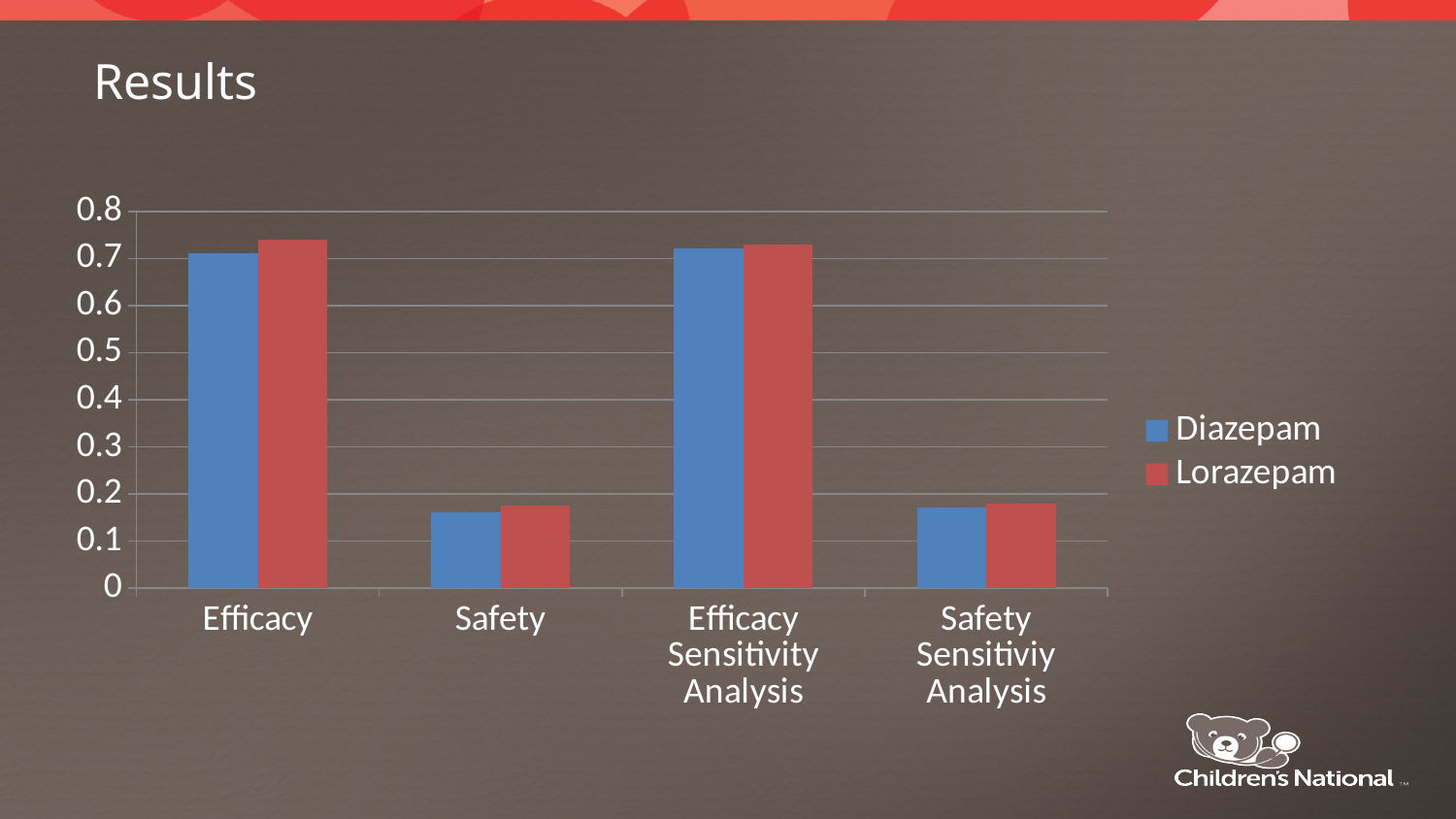
What is the title of the slide containing the chart? Results Is the Lorazepam value for Safety Sensitiviy Analysis greater or less than 0.2? less Is the Lorazepam value for Efficacy greater or less than 0.7? greater For Efficacy, which series has the larger value, Diazepam or Lorazepam? Lorazepam Is the Diazepam value for Safety greater or less than 0.2? less How many series does the chart's legend list? 2 Which series is shown in red in the chart's legend? Lorazepam For Diazepam, which is larger, the value for Efficacy or the value for Safety? Efficacy How many categories are shown on the x axis of the chart? 4 What kind of chart is shown on the slide? bar chart